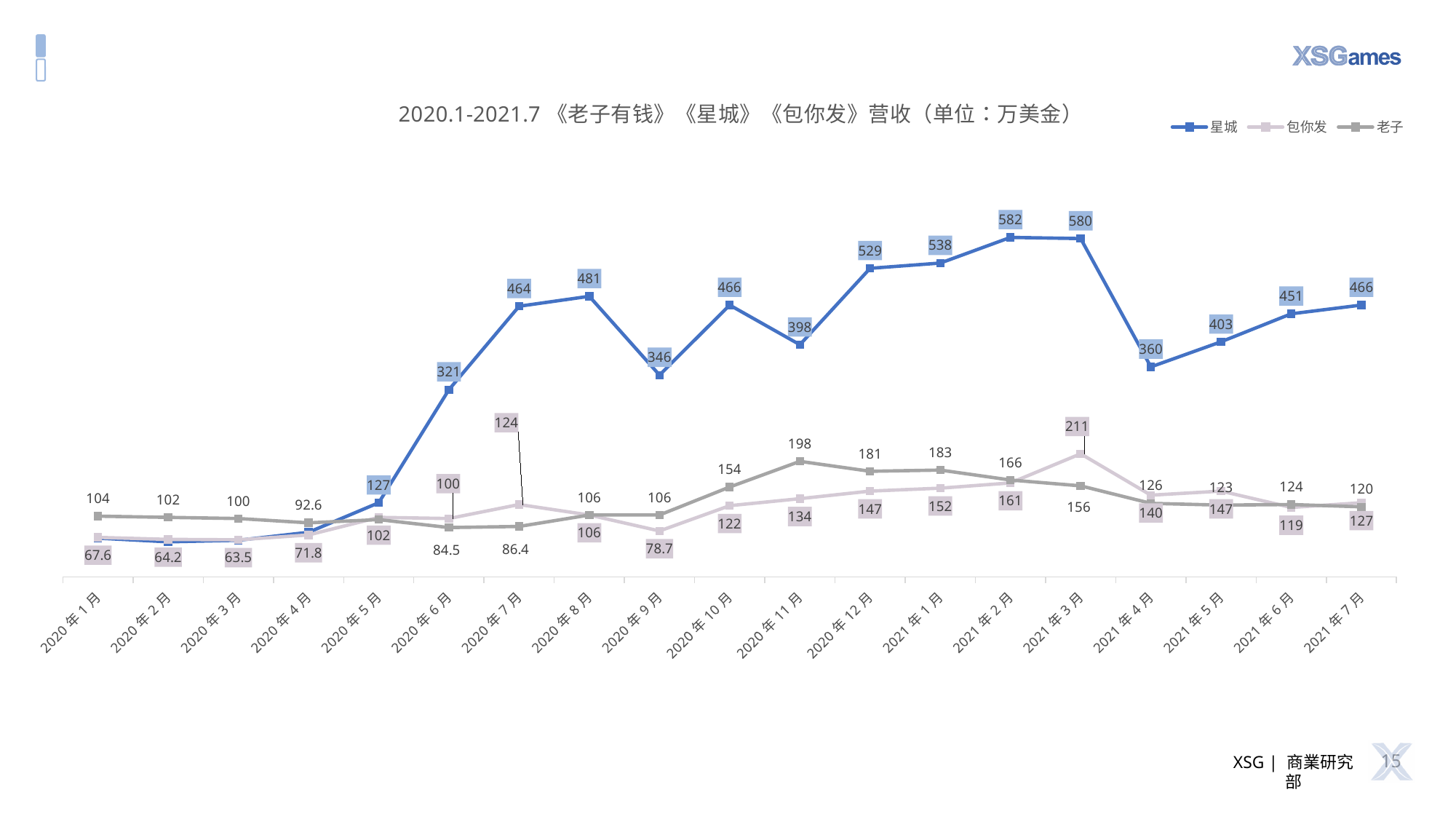
Which series has the higher revenue in 2020年12月, 老子 or 包你发? 老子 What is the revenue of 包你发 in 2021年3月? 211 What is the revenue of 老子 in 2020年11月? 198 What is the revenue of 星城 in 2020年8月? 481 What is the revenue of 星城 in 2021年7月? 466 In which month does 星城 reach its highest revenue? 2021年2月 How many series does the legend list? 3 What type of chart is shown on the slide? line chart In which month does 老子 reach its highest revenue? 2020年11月 How many months are plotted along the x axis? 19 Which series is drawn in blue according to the legend? 星城 What is the difference between 星城's revenue in 2021年3月 and 2021年4月? 220